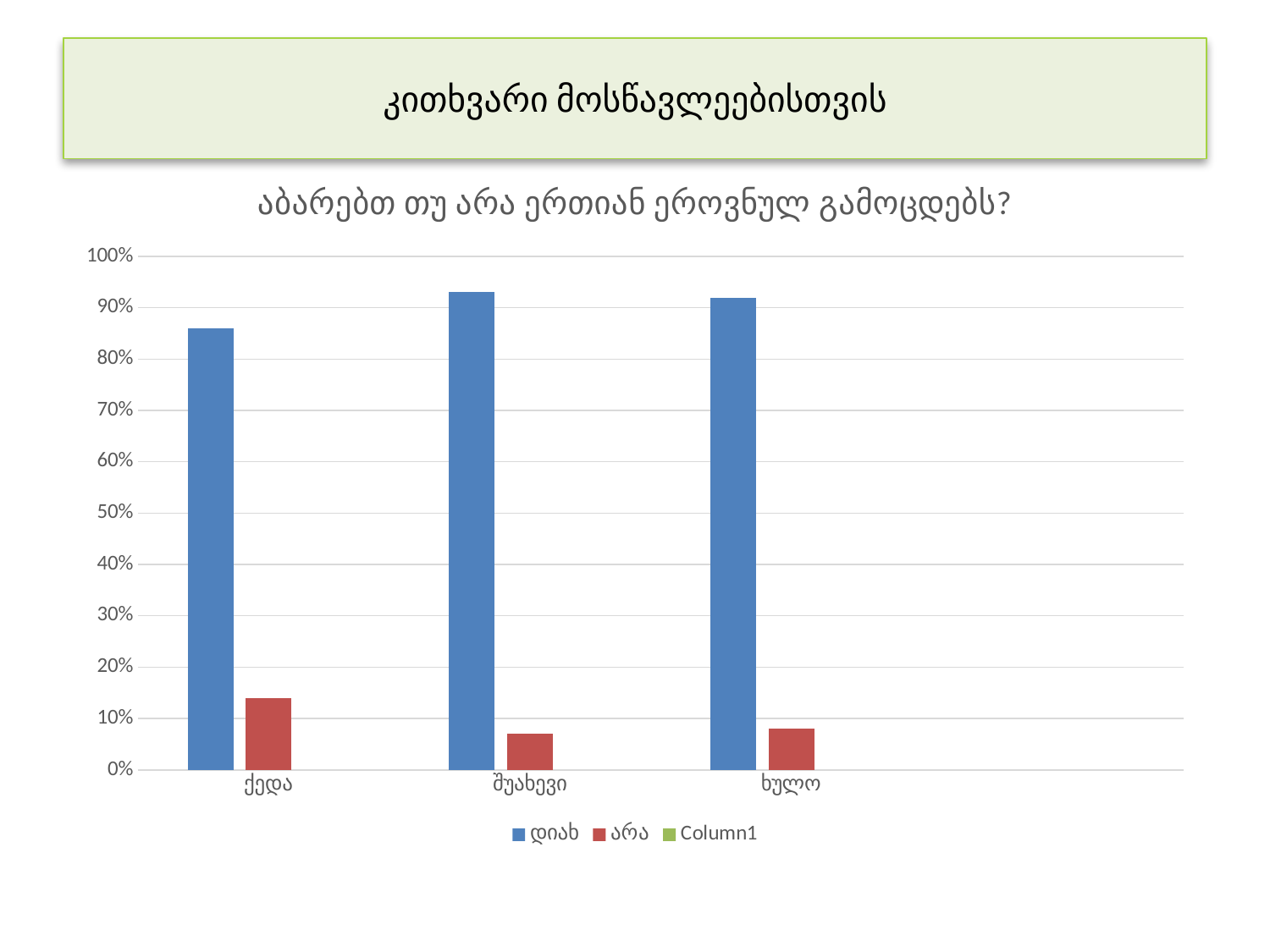
How many categories are shown on the x axis of the chart? 3 What kind of chart is shown on the slide? bar chart Which colour represents the series "დიახ" in the chart? blue Is the value for "არა" in შუახევი greater or less than 10%? less Is the value for "არა" in ქედა greater or less than 10%? greater Is the value for "დიახ" in ქედა greater or less than 80%? greater What is the title of the chart? აბარებთ თუ არა ერთიან ეროვნულ გამოცდებს? Which category has the lowest value for the series "დიახ"? ქედა How many series does the chart's legend list? 3 Which category has the highest value for the series "არა"? ქედა Which is larger: the "დიახ" value for ქედა or the "დიახ" value for ხულო? ხულო